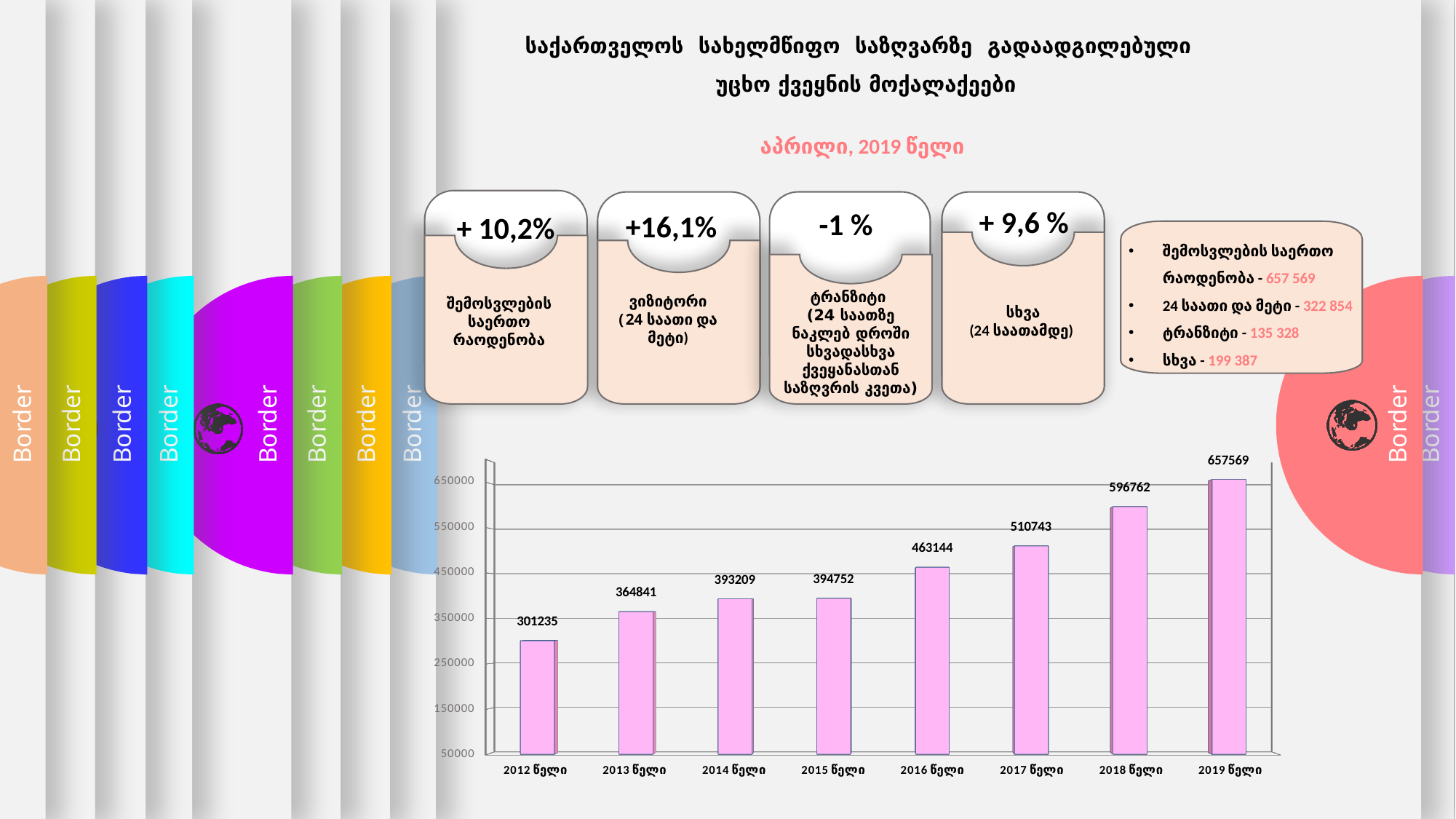
What is the difference between the values for 2019 and 2018? 60807 Which year has the lowest value in the bar chart? 2012 წელი What is the value shown for 2012 (2012 წელი)? 301235 What kind of chart is shown on the slide? bar chart Which year has the highest value in the bar chart? 2019 წელი What is the difference between the values for 2013 and 2012? 63606 What is the value shown for 2016 (2016 წელი)? 463144 Is the value for 2018 greater or less than 550000? greater How many years (bars) are shown in the chart? 8 What is the value shown for 2019 (2019 წელი)? 657569 Which is larger, the value for 2017 or the value for 2016? 2017 წელი Do the values rise or fall from 2012 to 2019? rise